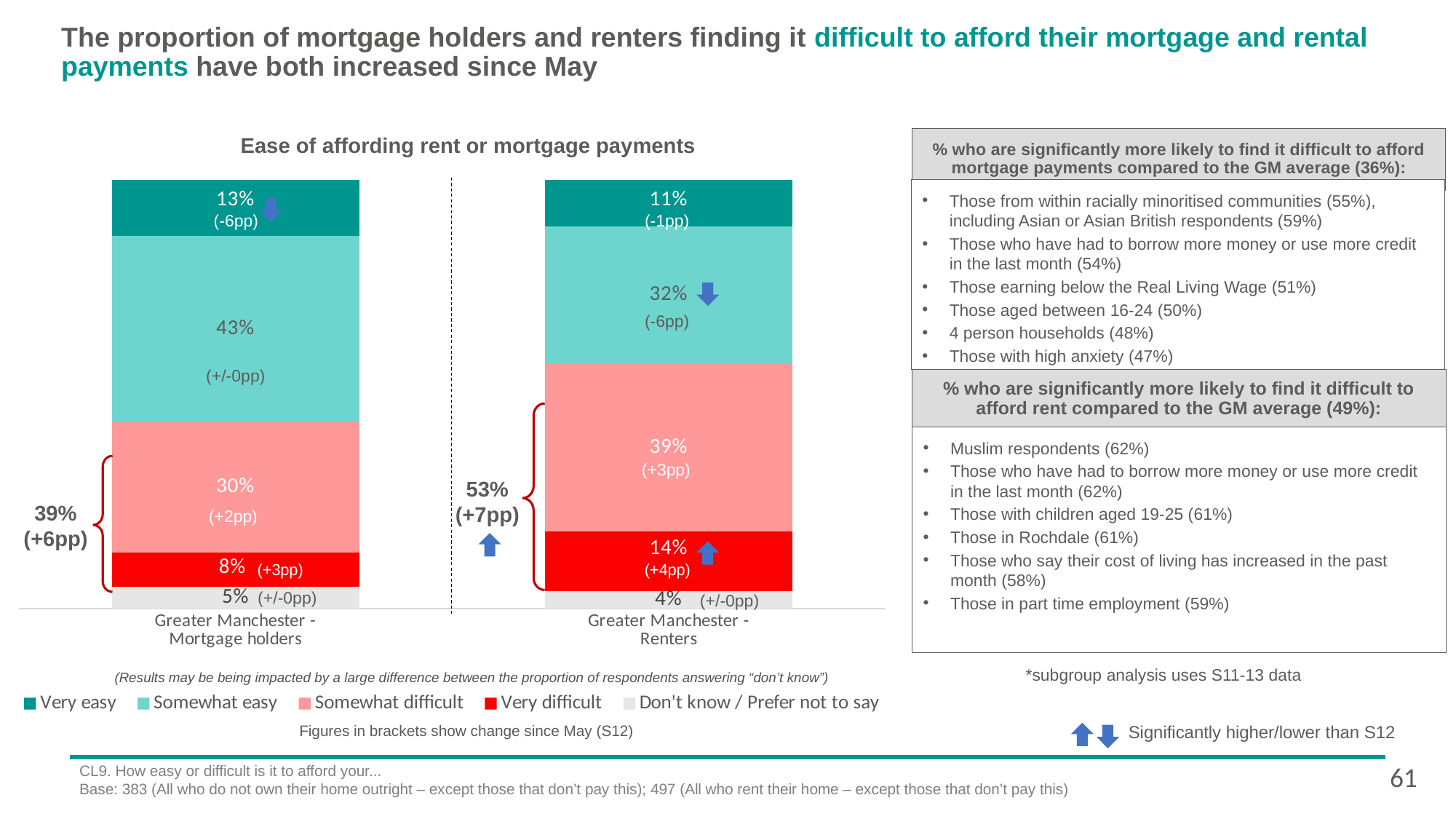
What percentage of Greater Manchester mortgage holders find it somewhat easy to afford their payments? 43% Which group has a higher 'Very easy' percentage, mortgage holders or renters? Mortgage holders What percentage of Greater Manchester renters find it somewhat difficult to afford their rent? 39% What is the difference between the 'Very difficult' percentages for renters and mortgage holders? 6 percentage points What type of chart is shown on the slide? Stacked bar chart What is the combined proportion of Greater Manchester mortgage holders finding it difficult (somewhat or very) to afford their payments, as shown by the bracket? 39% What is the change since May in the proportion of renters finding it difficult to afford rent, as shown in brackets? +7pp How many series does the legend list? 5 How many categories (bars) are shown on the chart? 2 Which response category is the largest for Greater Manchester mortgage holders? Somewhat easy What percentage of Greater Manchester renters find it very difficult to afford their rent? 14% Which response category is the smallest for Greater Manchester renters? Don't know / Prefer not to say